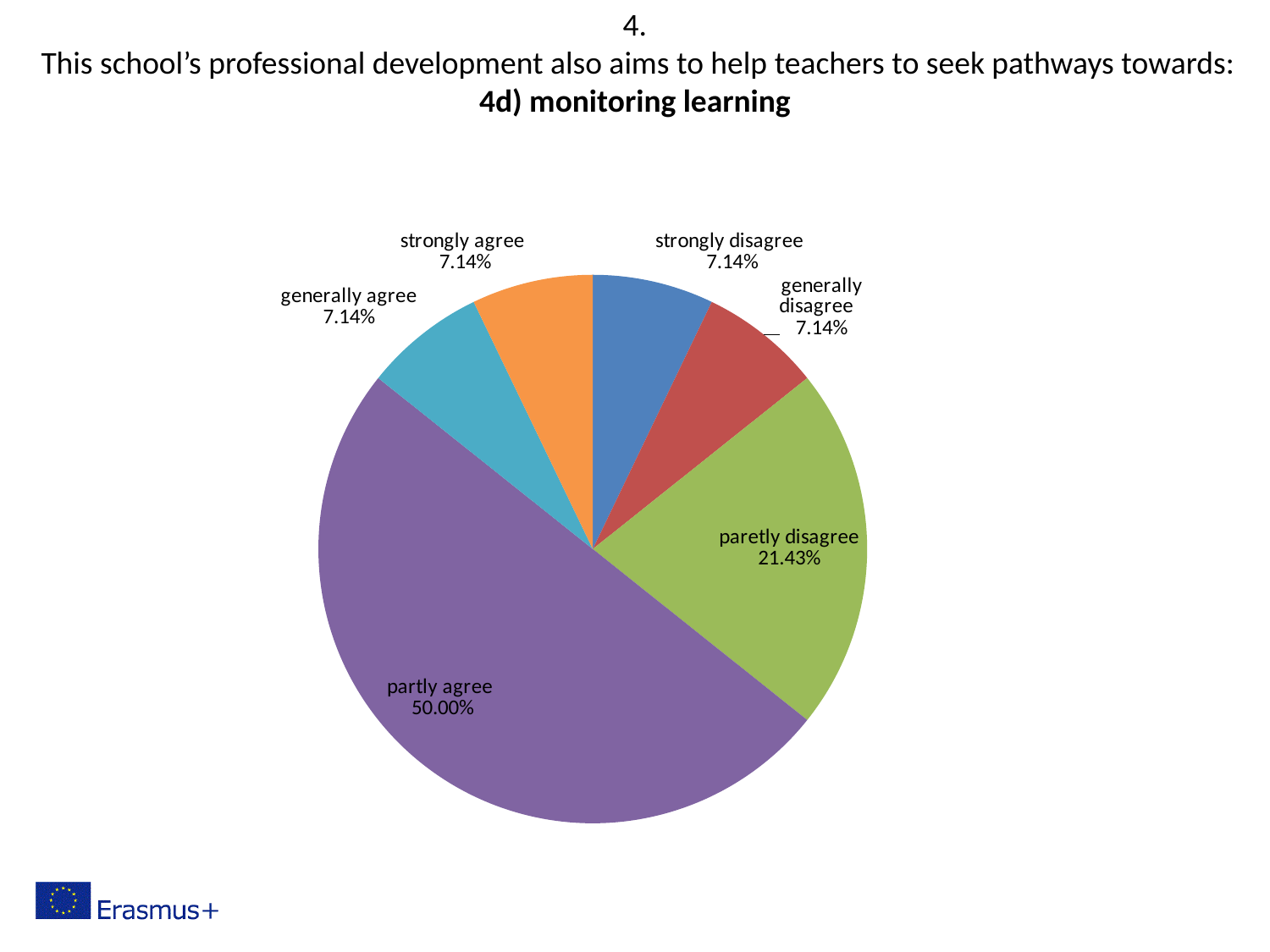
How many categories share the value 7.14%? 4 How many slices does the pie chart have? 6 What colour is the "partly agree" slice? purple What kind of chart is shown on the slide? pie chart What share of the pie is labelled "paretly disagree"? 21.43% What share of the pie is labelled "strongly disagree"? 7.14% What is the combined share of "strongly agree" and "generally agree"? 14.28% What share of the pie is labelled "generally agree"? 7.14% What is the difference between the "partly agree" share and the "paretly disagree" share? 28.57% What share of the pie is labelled "partly agree"? 50.00% Which category has the largest slice of the pie? partly agree Which is larger, the "paretly disagree" slice or the "strongly agree" slice? paretly disagree